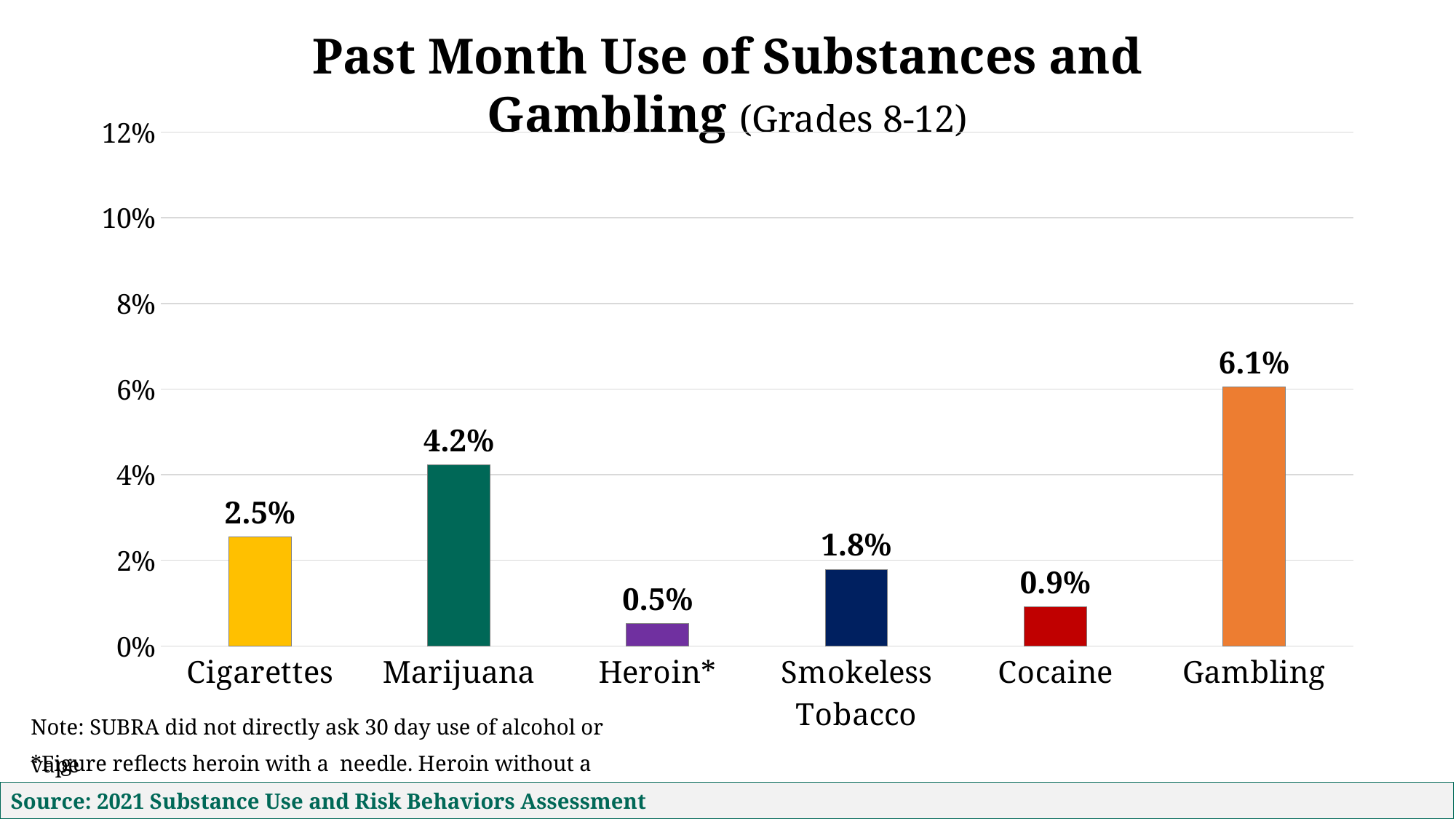
Is the value for Gambling greater or less than 8%? less What is the difference between the values for Gambling and Marijuana? 1.9% What is the source cited at the bottom of the slide? 2021 Substance Use and Risk Behaviors Assessment What is the past month use value for Marijuana? 4.2% What kind of chart is shown on the slide? Bar chart What is the difference between the values for Cigarettes and Cocaine? 1.6% What is the value shown for Smokeless Tobacco? 1.8% What is the value shown for Cocaine? 0.9% Which is larger, the value for Cigarettes or the value for Smokeless Tobacco? Cigarettes Which category has the lowest value? Heroin* Which category has the highest value? Gambling How many categories are shown on the chart? 6